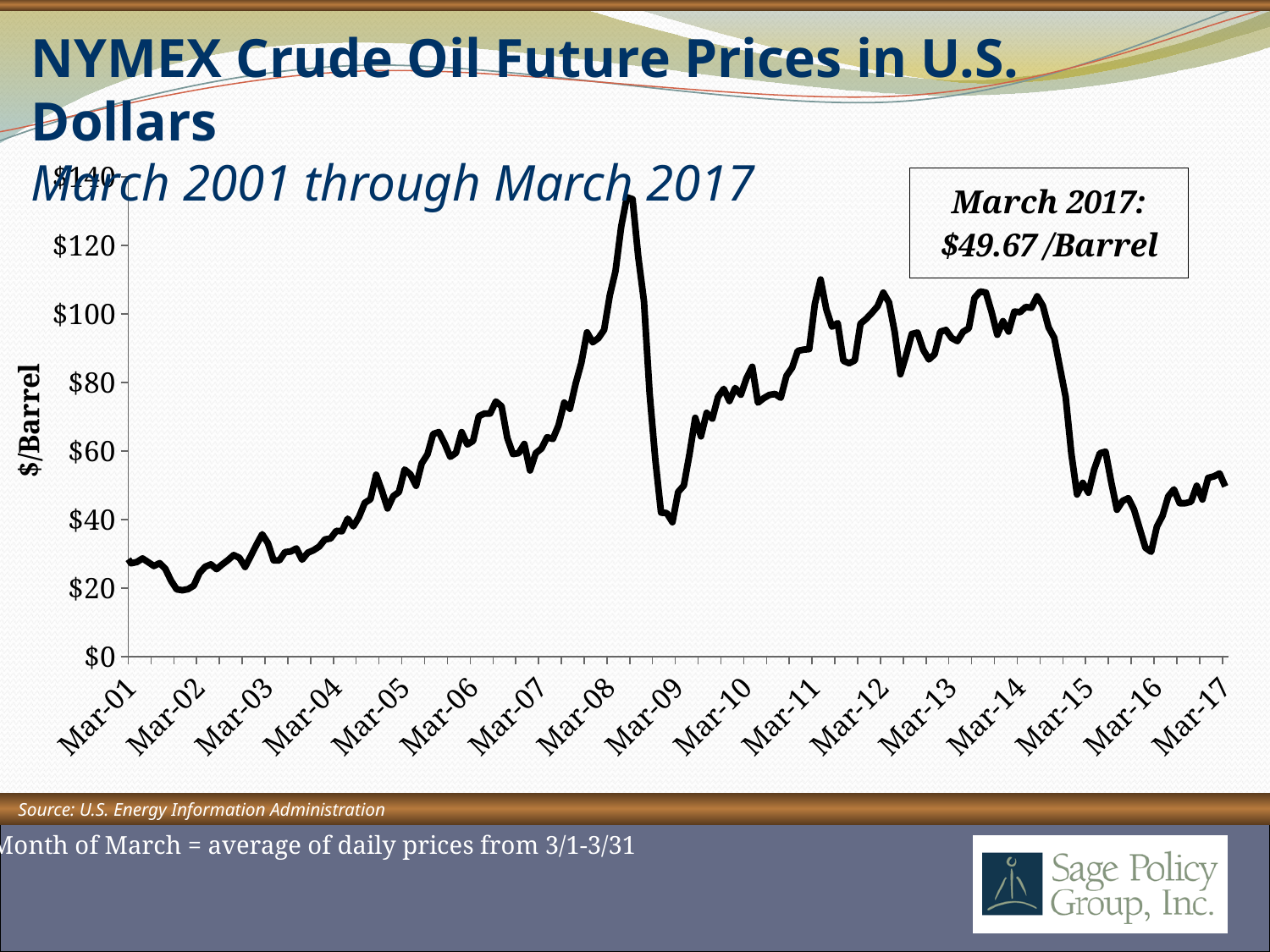
Between Mar-14 and Mar-15, does the line rise or fall? fall Is the value at Mar-12 greater or less than $80? greater Near which x-axis label does the line reach its lowest point? Mar-02 Which is larger, the value at Mar-11 or the value at Mar-16? Mar-11 In which year does the line reach its highest point? 2008 What kind of chart is shown on the slide? line chart How many labels are shown on the x axis? 17 Is the value at Mar-02 greater or less than $40? less What is the crude oil price for March 2017 according to the annotation on the chart? $49.67/Barrel What is the label on the y axis? $/Barrel Is the value at Mar-16 greater or less than $60? less